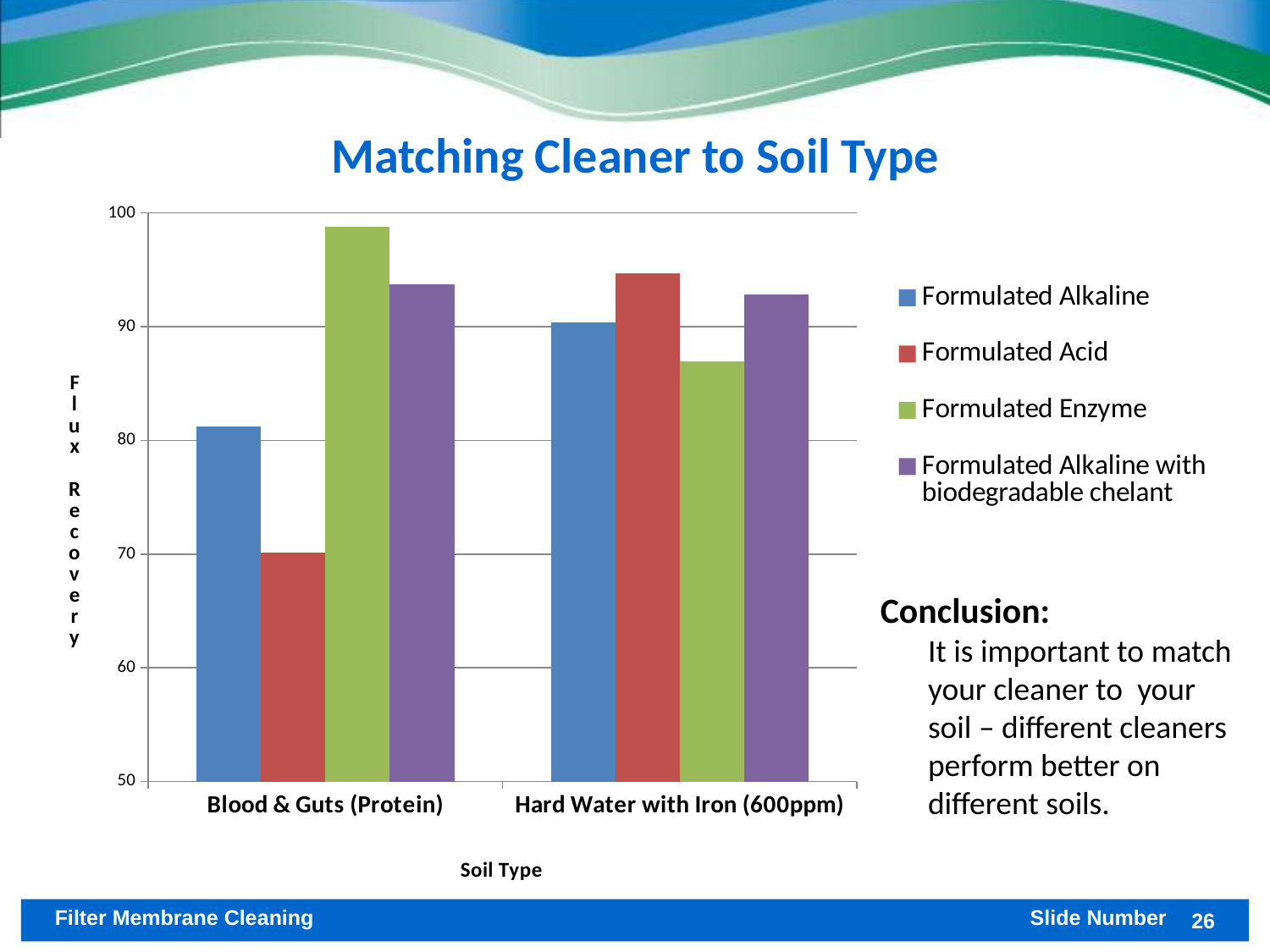
Which cleaner has the lowest flux recovery for Blood & Guts (Protein)? Formulated Acid Is the flux recovery for Formulated Enzyme on Hard Water with Iron (600ppm) greater or less than 90? less What is the title of the chart's x axis? Soil Type Is the flux recovery for Formulated Enzyme higher for Blood & Guts (Protein) or for Hard Water with Iron (600ppm)? Blood & Guts (Protein) Which cleaner has the highest flux recovery for Blood & Guts (Protein)? Formulated Enzyme How many series does the chart's legend list? 4 Is the flux recovery for Formulated Acid on Hard Water with Iron (600ppm) greater or less than 90? greater Is the flux recovery for Formulated Acid on Blood & Guts (Protein) greater or less than 80? less What kind of chart is shown on the slide? bar chart How many soil types are shown on the x axis of the chart? 2 Which cleaner has the highest flux recovery for Hard Water with Iron (600ppm)? Formulated Acid Which cleaner has the lowest flux recovery for Hard Water with Iron (600ppm)? Formulated Enzyme